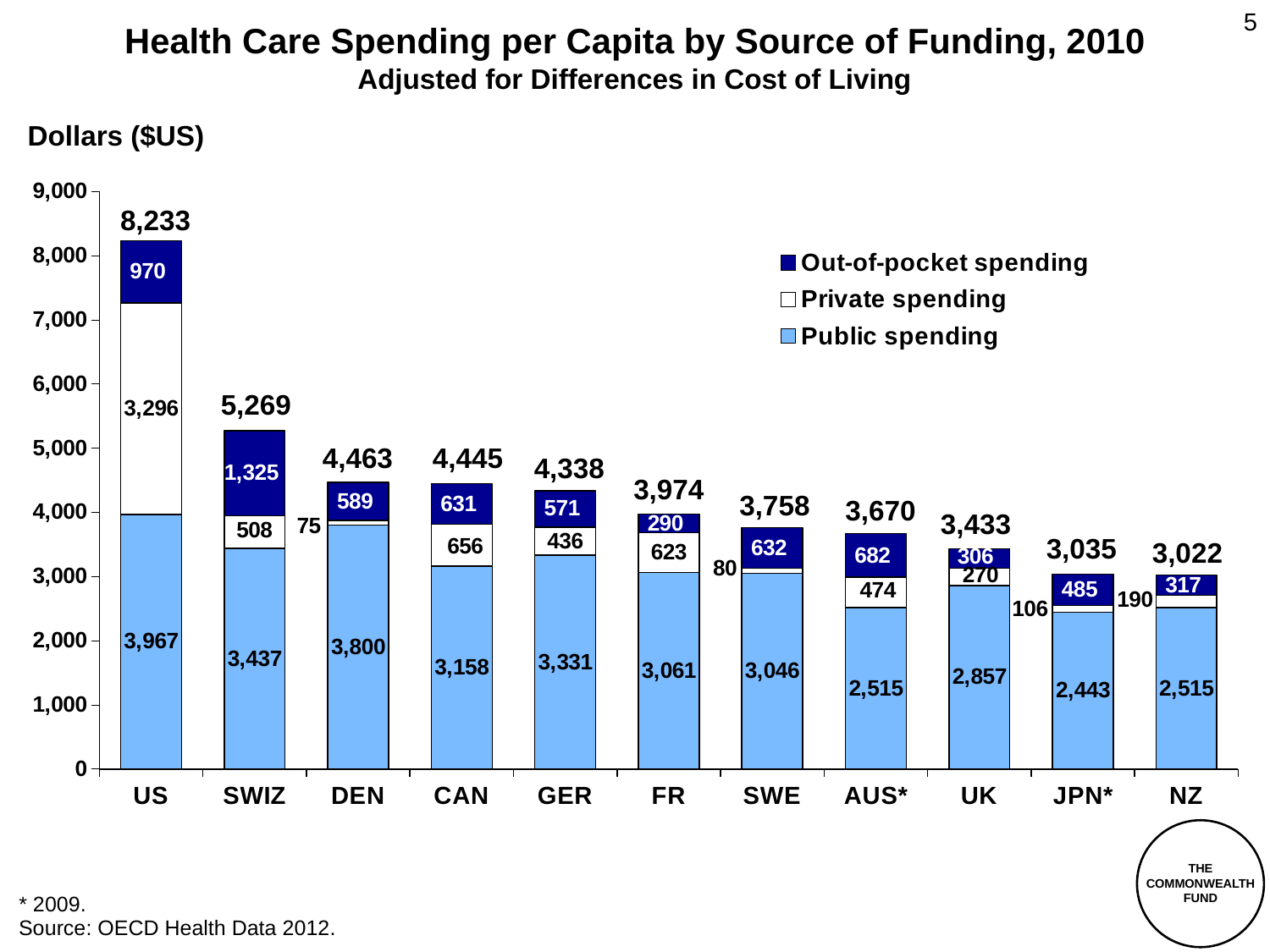
Which has higher public spending, Denmark (DEN) or Sweden (SWE)? DEN Which country has the lowest total health care spending per capita? NZ What is the out-of-pocket spending value for Switzerland (SWIZ)? 1,325 What is the total health care spending per capita for the US? 8,233 How many series does the legend list? 3 What is the public spending value for Germany (GER)? 3,331 What kind of chart is shown on the slide? Stacked bar chart Do the total spending values rise or fall moving from left to right along the x axis? Fall What is the difference between the total spending of the US and Switzerland (SWIZ)? 2,964 How many countries are shown on the x axis? 11 Which country has the highest total health care spending per capita? US What is the private spending value for Canada (CAN)? 656